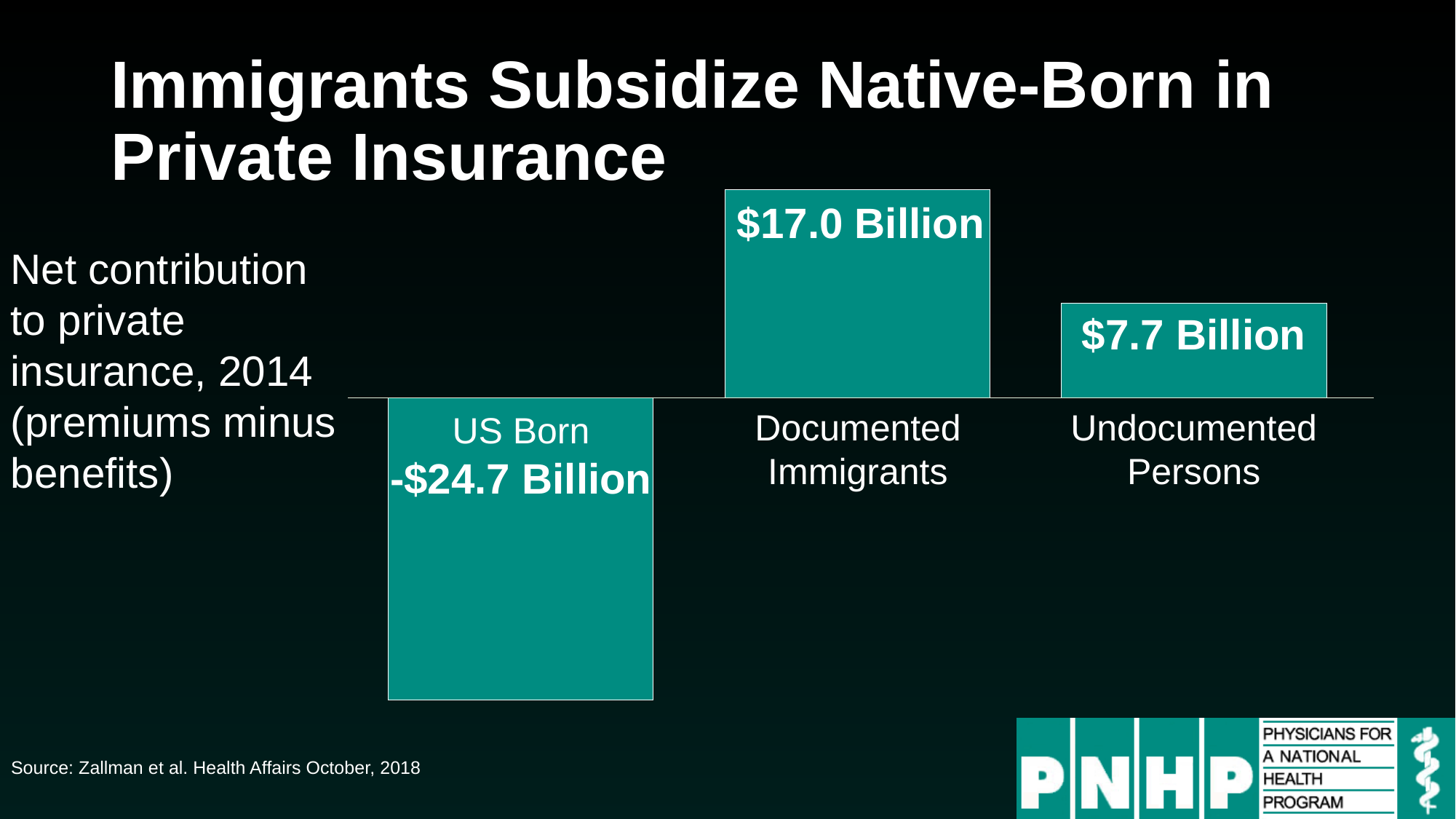
Which category is the only one with a negative net contribution? US Born Which category has the lowest net contribution to private insurance? US Born What kind of chart is shown on the slide? Bar chart What year does the chart's net contribution data refer to? 2014 Which category has the highest net contribution to private insurance? Documented Immigrants What is the difference between the net contributions of Documented Immigrants and Undocumented Persons? $9.3 Billion What is the net contribution to private insurance for Documented Immigrants? $17.0 Billion What is the net contribution to private insurance for US Born? -$24.7 Billion How many categories are shown in the chart? 3 Which is larger, the net contribution of Documented Immigrants or of Undocumented Persons? Documented Immigrants What is the net contribution to private insurance for Undocumented Persons? $7.7 Billion